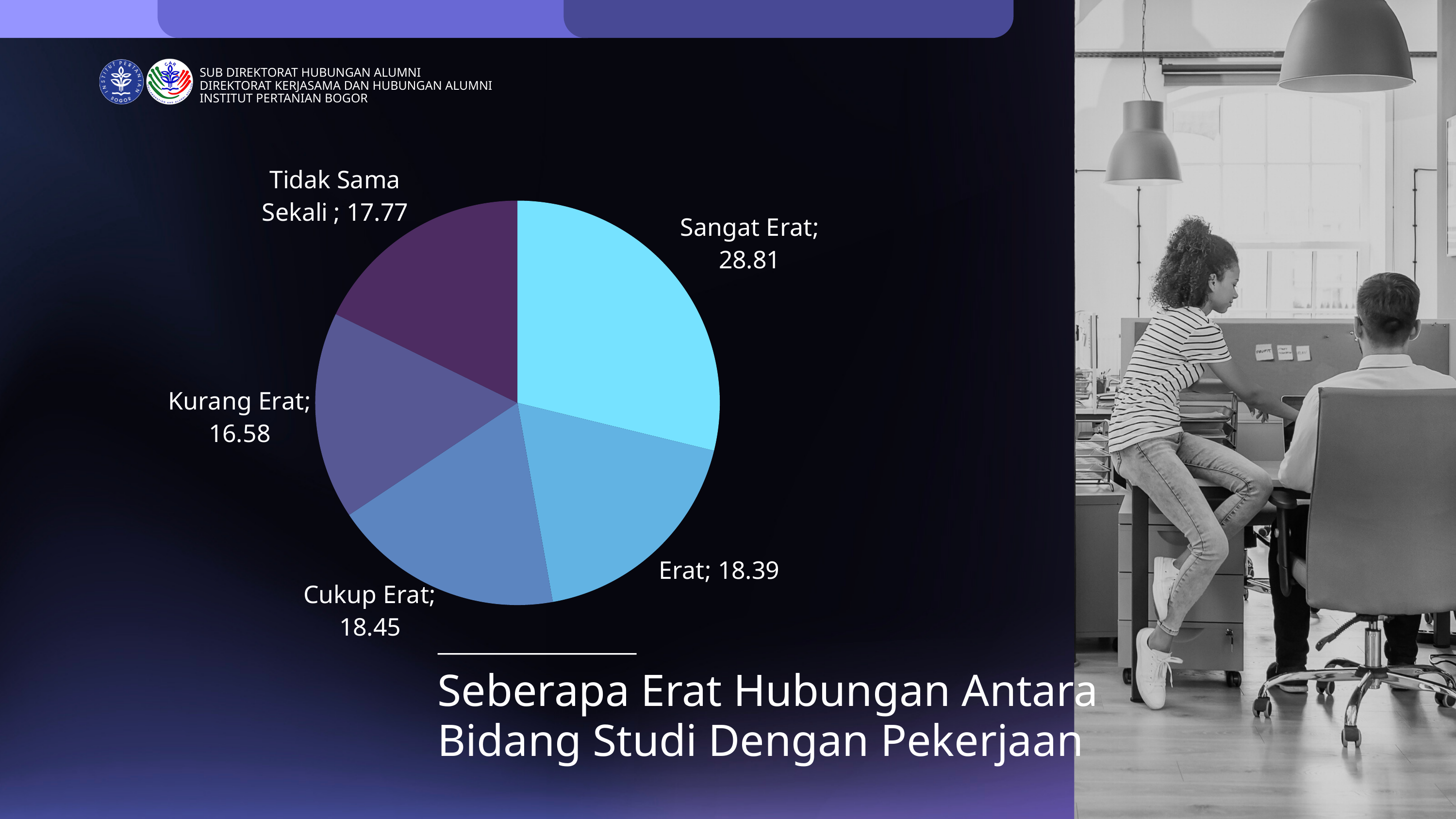
Which is larger, the value for Sangat Erat or the value for Tidak Sama Sekali? Sangat Erat What is the value for Kurang Erat in the pie chart? 16.58 What is the value for Tidak Sama Sekali in the pie chart? 17.77 What is the value for Sangat Erat in the pie chart? 28.81 What is the title of the chart on the slide? Seberapa Erat Hubungan Antara Bidang Studi Dengan Pekerjaan What is the difference between the values for Sangat Erat and Erat? 10.42 Which category has the smallest slice in the pie chart? Kurang Erat What is the difference between the values for Sangat Erat and Kurang Erat? 12.23 How many categories are shown in the pie chart? 5 What kind of chart is shown on the slide? Pie chart Which category has the largest slice in the pie chart? Sangat Erat What is the value for Cukup Erat in the pie chart? 18.45